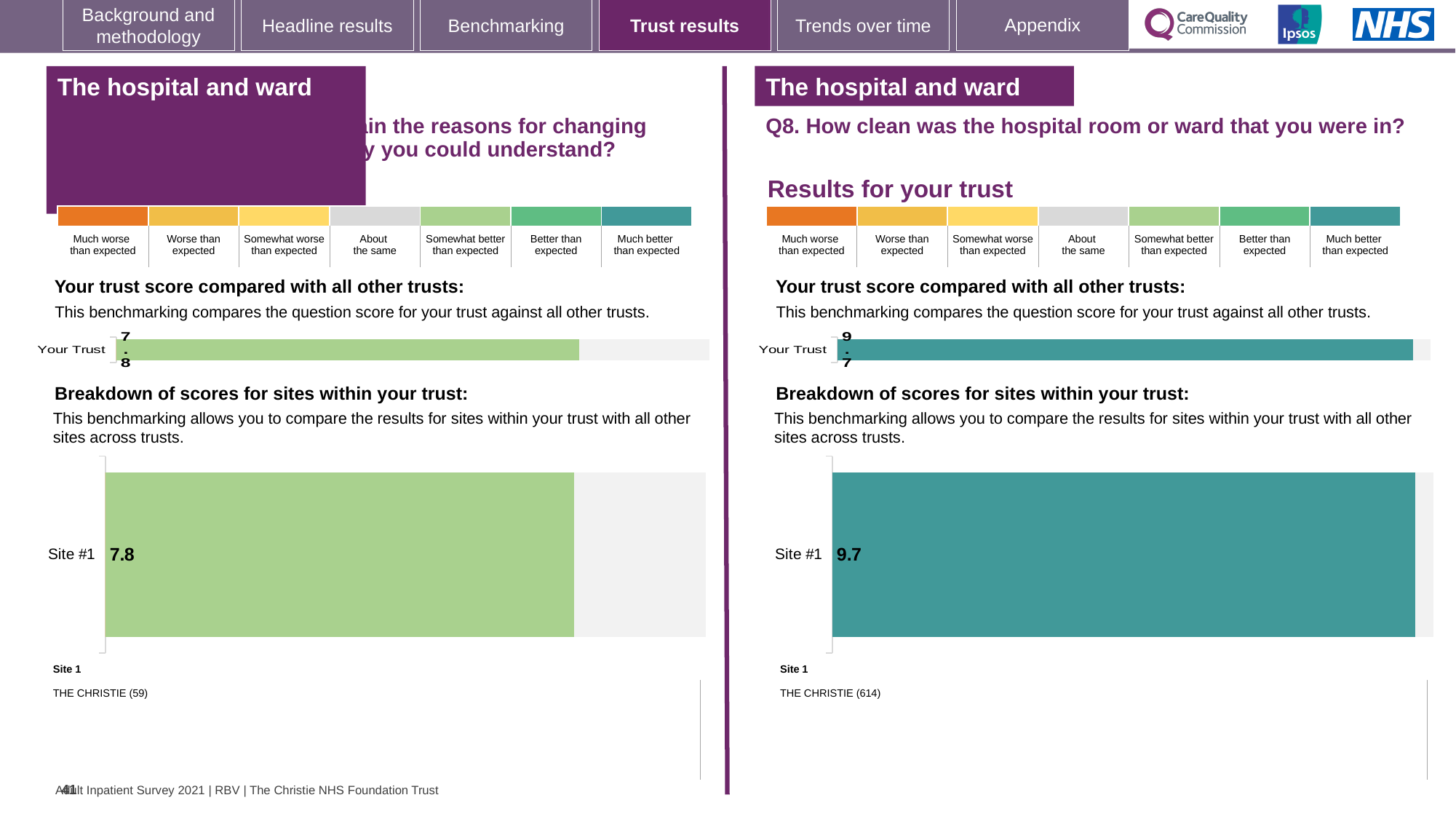
What is the difference between the Site #1 score on the right-hand chart (9.7) and the Site #1 score on the left-hand chart (7.8)? 1.9 What kind of chart is used to show the Site #1 score on the right-hand side of the slide? Bar chart How many sites are shown in the left-hand 'Breakdown of scores for sites within your trust' chart? 1 Is the Your Trust score on the left-hand chart the same as the Site #1 score on the left-hand chart? Yes, both are 7.8 In the right-hand 'Breakdown of scores for sites within your trust' chart, what is the score for Site #1? 9.7 Which site name is listed under the right-hand site breakdown chart, and how many respondents are shown in brackets? THE CHRISTIE (614) Which site name is listed under the left-hand site breakdown chart, and how many respondents are shown in brackets? THE CHRISTIE (59) On the left-hand chart, what is the score shown for Your Trust? 7.8 In the left-hand 'Breakdown of scores for sites within your trust' chart, what is the score for Site #1? 7.8 On the right-hand chart for Q8 (How clean was the hospital room or ward), what is the score shown for Your Trust? 9.7 Which is larger: the Site #1 score on the left-hand chart or the Site #1 score on the right-hand chart? The right-hand chart (9.7) How many sites are shown in the right-hand 'Breakdown of scores for sites within your trust' chart? 1